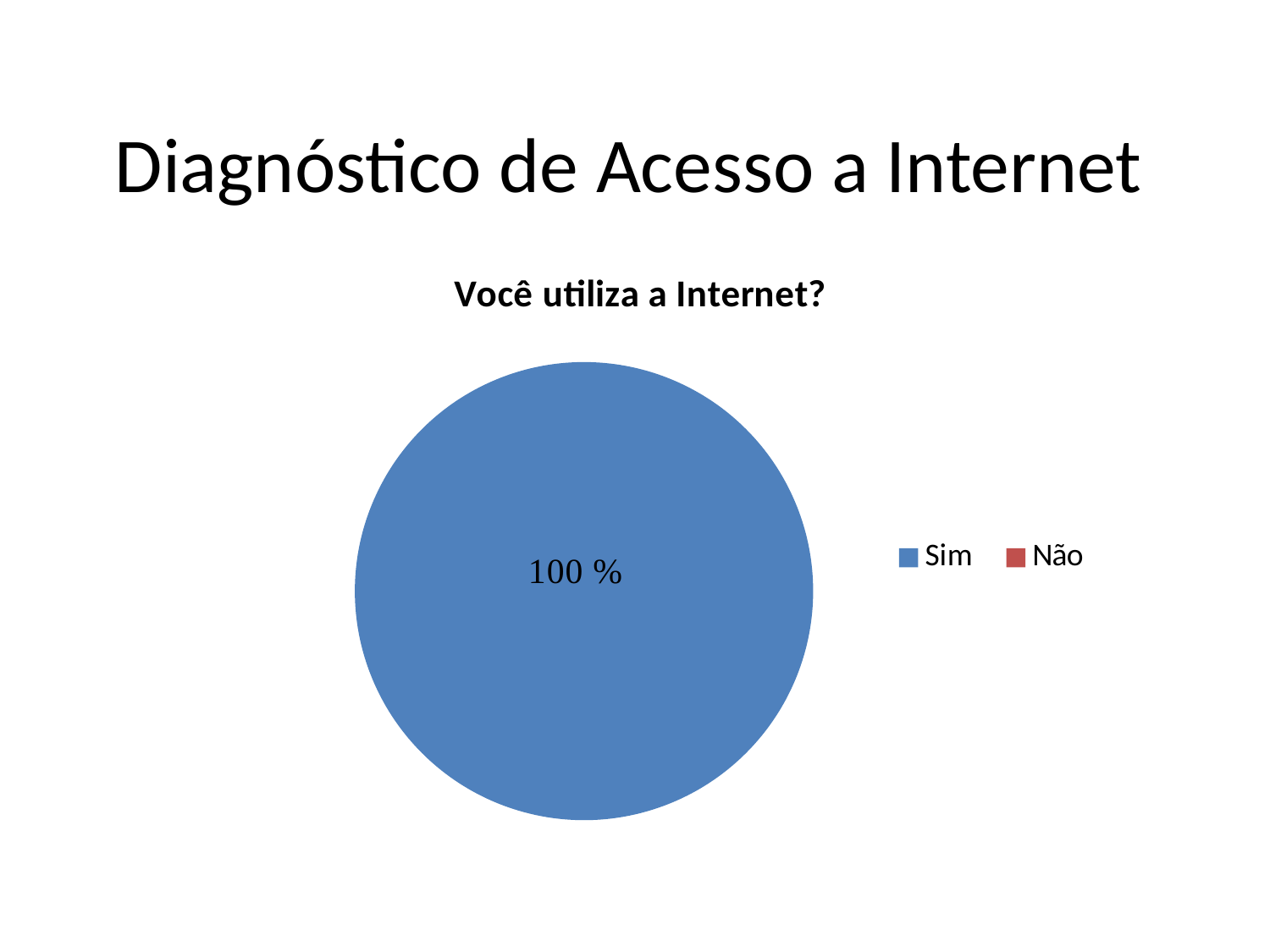
Which is larger, the slice for "Sim" or the slice for "Não"? Sim Which category has the smallest slice of the pie? Não How many entries does the chart legend list? 2 What is the title of the chart? Você utiliza a Internet? What colour is the "Sim" slice in the pie chart? blue What kind of chart is shown on the slide? pie chart What is the value printed on the pie chart? 100 % Which category has the largest slice of the pie? Sim What share of the pie does the "Sim" slice take? 100 %